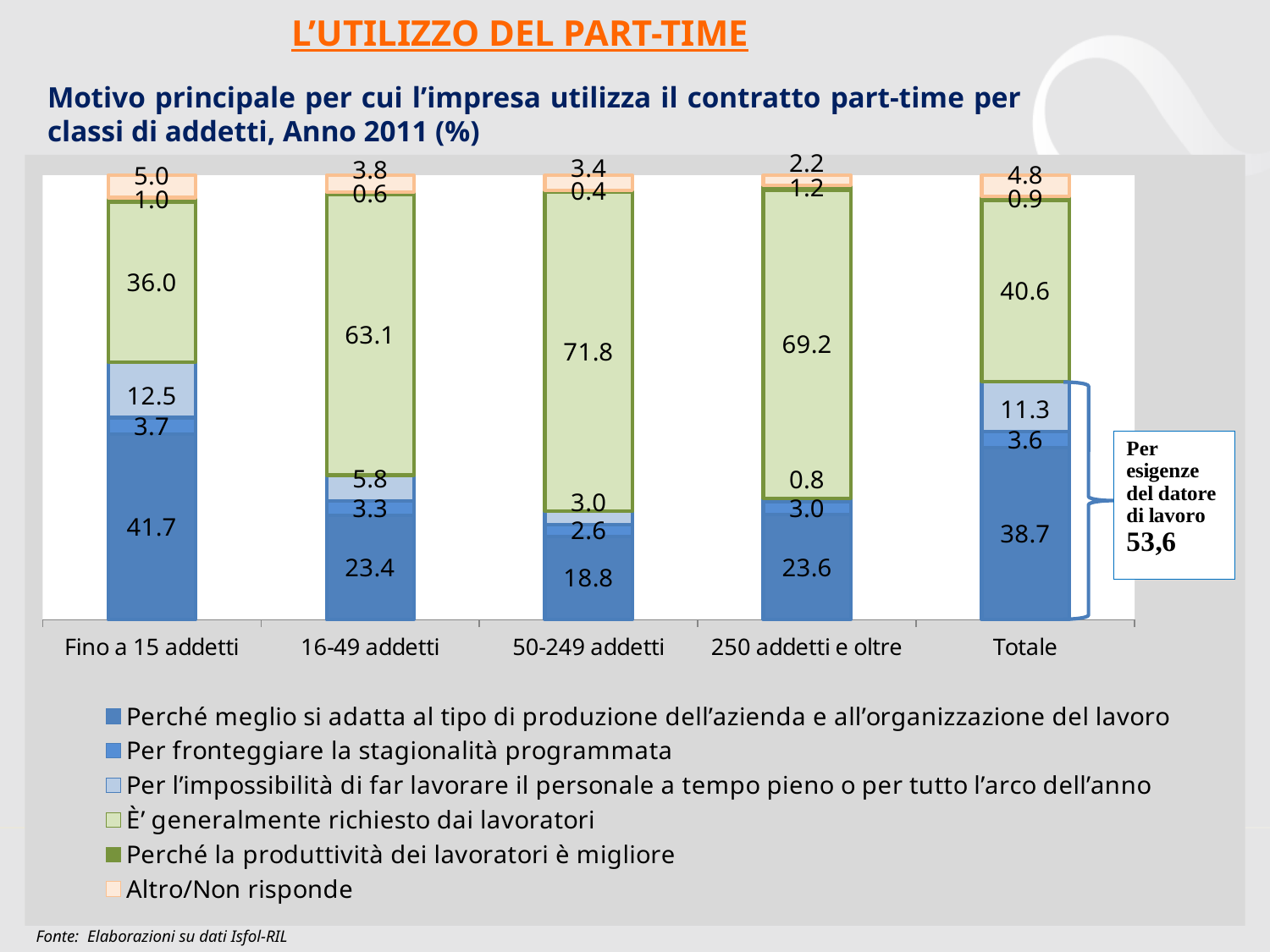
What value does the callout "Per esigenze del datore di lavoro" give for the Totale bar? 53,6 Which category has the highest value for "È' generalmente richiesto dai lavoratori"? 50-249 addetti What is the difference between the Totale and 16-49 addetti values for "Perché meglio si adatta al tipo di produzione dell'azienda e all'organizzazione del lavoro"? 15.3 What is the value of "È' generalmente richiesto dai lavoratori" for 50-249 addetti? 71.8 What kind of chart is shown on the slide? Stacked bar chart How many series does the legend list? 6 Which is larger for "Altro/Non risponde": Fino a 15 addetti or Totale? Fino a 15 addetti What is the value of "Altro/Non risponde" for 250 addetti e oltre? 2.2 What is the value of "Perché meglio si adatta al tipo di produzione dell'azienda e all'organizzazione del lavoro" for Fino a 15 addetti? 41.7 How many categories are shown on the x axis? 5 Which category has the lowest value for "Perché meglio si adatta al tipo di produzione dell'azienda e all'organizzazione del lavoro"? 50-249 addetti What is the value of "Per l'impossibilità di far lavorare il personale a tempo pieno o per tutto l'arco dell'anno" for Totale? 11.3